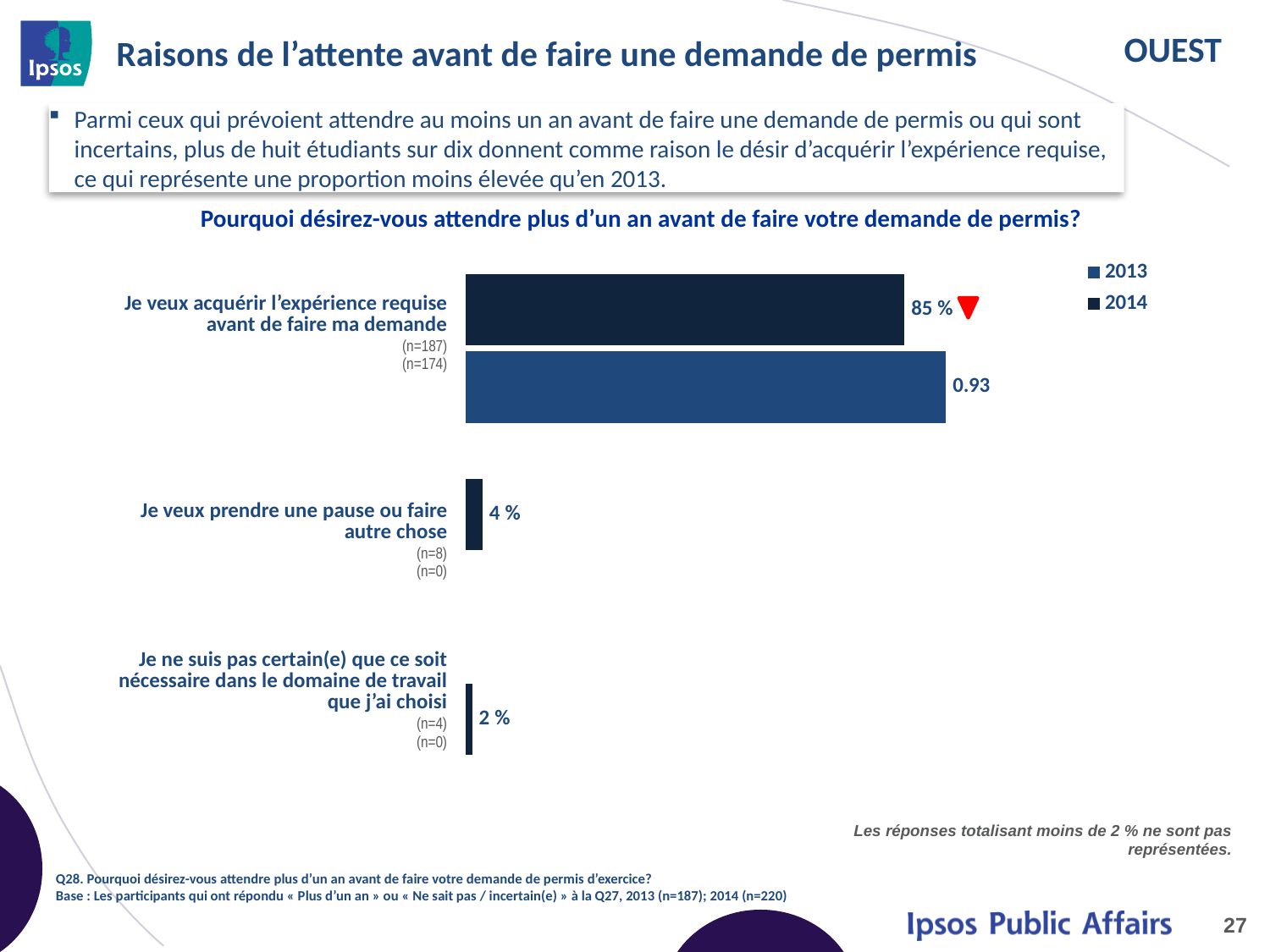
What are the two entries in the chart legend? 2013 and 2014 How many series does the chart legend list? 2 Which is larger: the value for "Je veux prendre une pause ou faire autre chose" or for "Je ne suis pas certain(e) que ce soit nécessaire dans le domaine de travail que j'ai choisi"? Je veux prendre une pause ou faire autre chose What kind of chart is shown on the slide? bar chart What is the difference between the values for "Je veux prendre une pause ou faire autre chose" and "Je ne suis pas certain(e) que ce soit nécessaire dans le domaine de travail que j'ai choisi"? 2 % Which reason has the highest 2014 value? Je veux acquérir l'expérience requise avant de faire ma demande How many reason categories are plotted in the chart? 3 What is the value shown for "Je ne suis pas certain(e) que ce soit nécessaire dans le domaine de travail que j'ai choisi"? 2 % Which reason has the lowest value in the chart? Je ne suis pas certain(e) que ce soit nécessaire dans le domaine de travail que j'ai choisi What is the 2013 value for "Je veux acquérir l'expérience requise avant de faire ma demande"? 0.93 What is the value shown for "Je veux prendre une pause ou faire autre chose"? 4 % What is the 2014 value for "Je veux acquérir l'expérience requise avant de faire ma demande"? 85 %